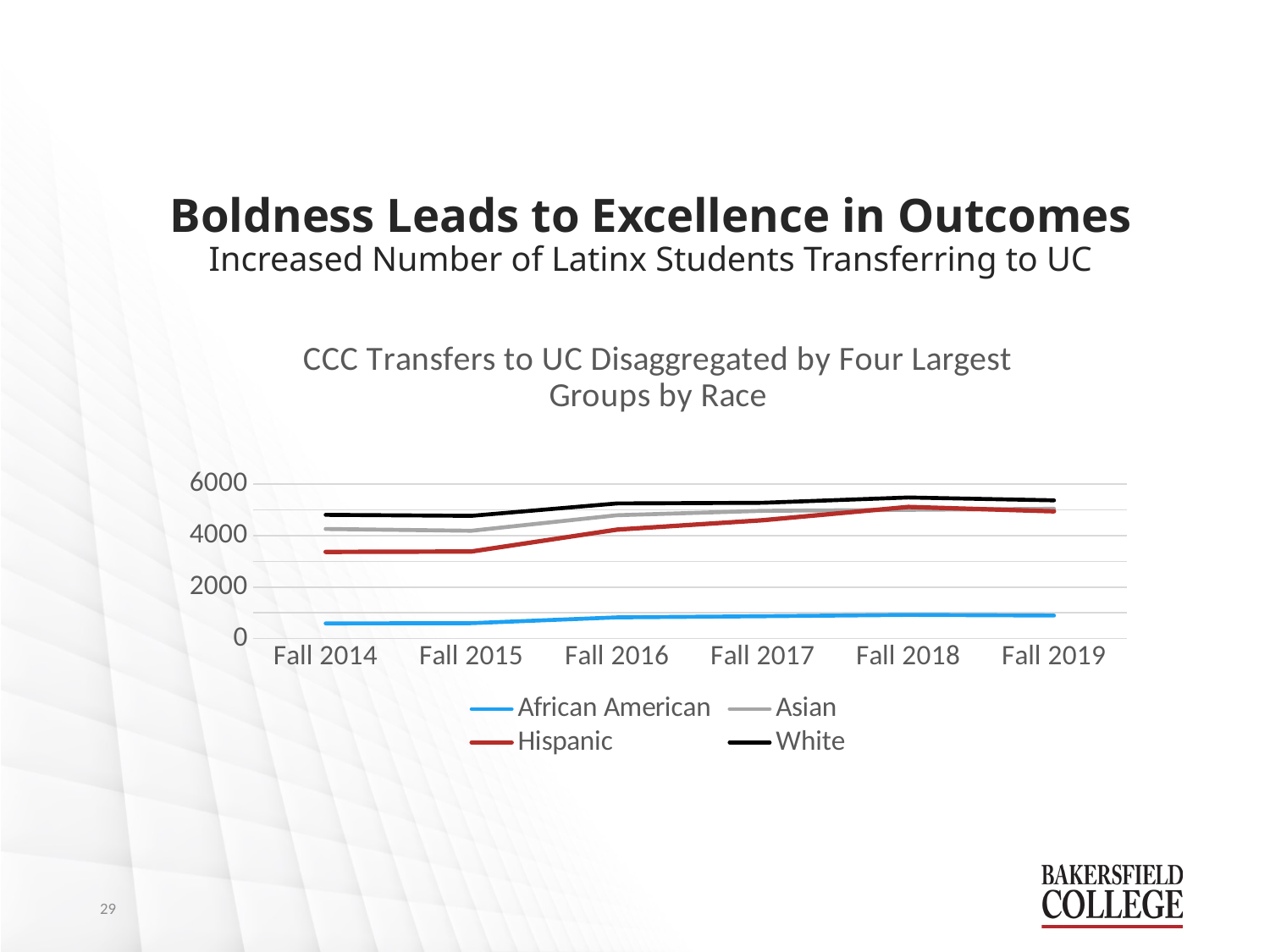
Which group has the highest number of transfers in Fall 2014? White Which group has the lowest number of transfers across all years shown? African American Is the value for Hispanic in Fall 2019 greater or less than 4000? greater Does the Hispanic line rise or fall from Fall 2014 to Fall 2019? rise Is the value for White in Fall 2014 greater or less than 4000? greater What kind of chart is shown on the slide? line chart How many time points are shown on the x axis? 6 Is the value for Hispanic in Fall 2014 greater or less than 4000? less How many series does the legend list? 4 In Fall 2014, which is larger: the value for Asian or the value for Hispanic? Asian What is the title of the chart? CCC Transfers to UC Disaggregated by Four Largest Groups by Race